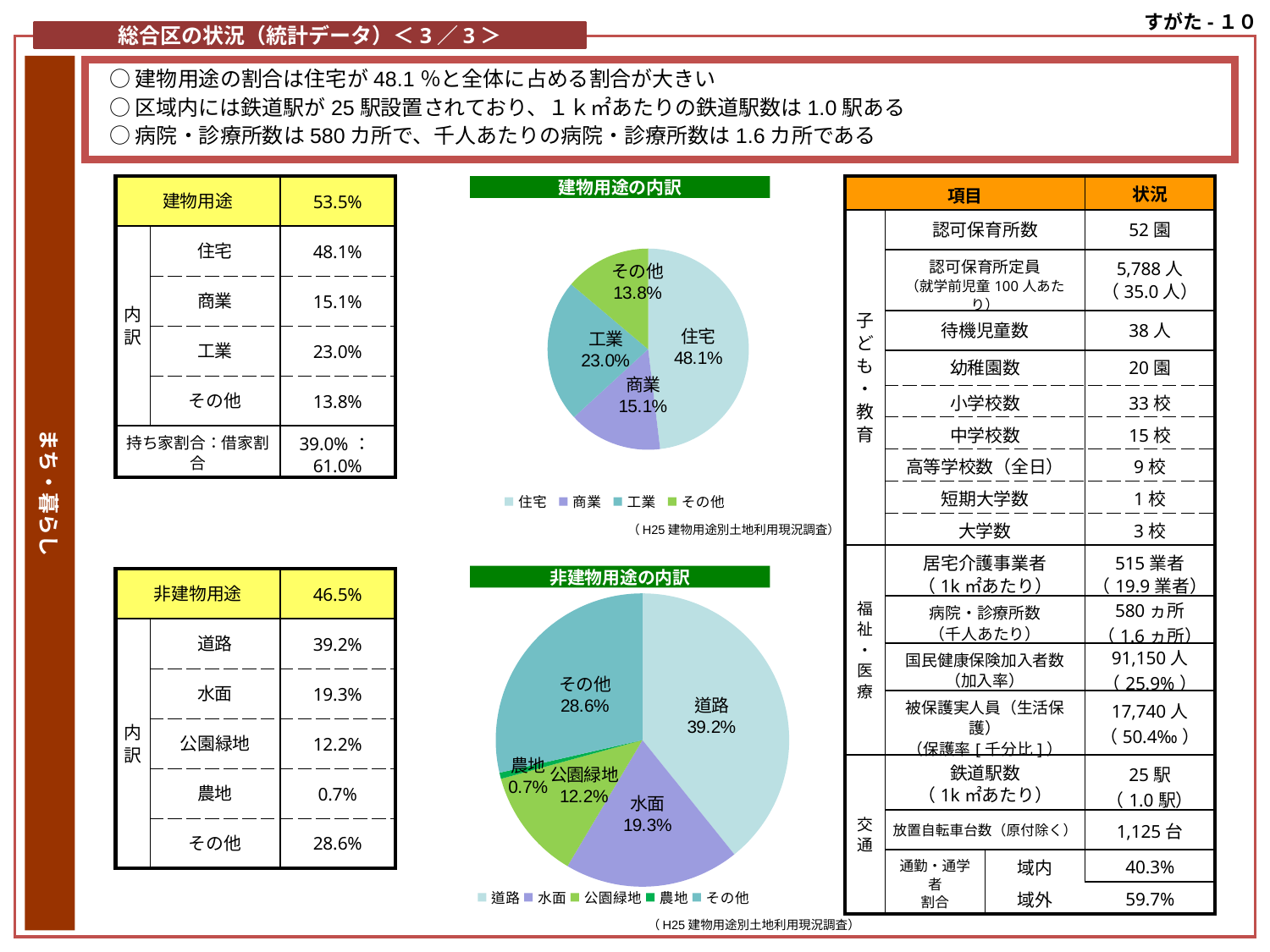
In the 非建物用途の内訳 pie chart, what share does 道路 have? 39.2% In the 非建物用途の内訳 pie chart, which category has the smallest share? 農地 In the 建物用途の内訳 pie chart, which category has the smallest share? その他 In the 建物用途の内訳 pie chart, what share does 住宅 have? 48.1% In the 建物用途の内訳 pie chart, what is the value for 工業? 23.0% In the 建物用途の内訳 pie chart, what is the difference between 工業 and 商業? 7.9% In the 建物用途の内訳 pie chart, which category has the largest share? 住宅 In the 非建物用途の内訳 pie chart, what is the value for 農地? 0.7% What type of chart is the 非建物用途の内訳 chart? Pie chart How many categories does the 建物用途の内訳 pie chart show? 4 How many entries does the legend of the 非建物用途の内訳 chart list? 5 In the 非建物用途の内訳 pie chart, which is larger, 水面 or 公園緑地? 水面